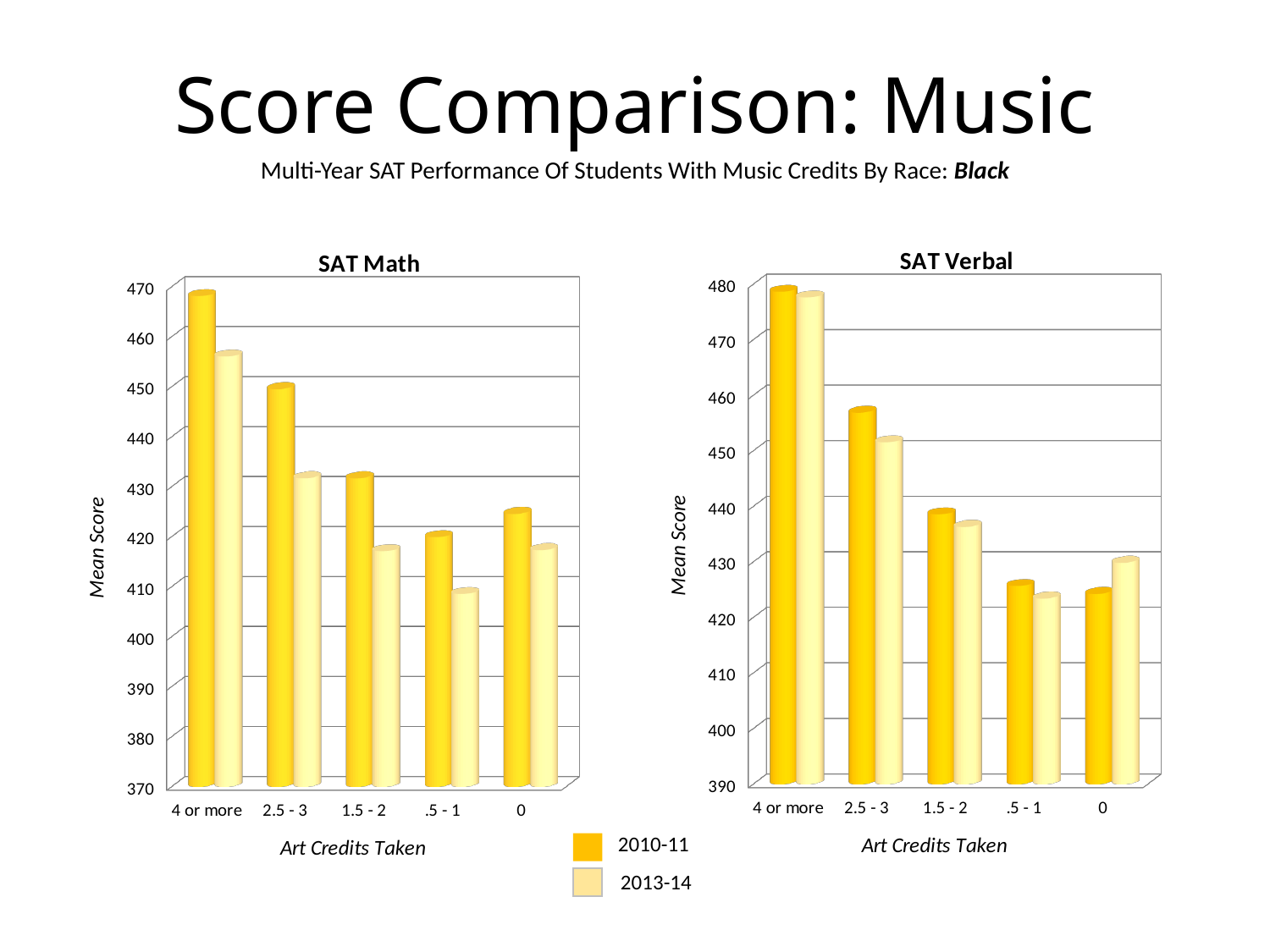
In the SAT Verbal chart, which Art Credits Taken category has the lowest 2013-14 mean score? .5 - 1 In the SAT Math chart, is the 2010-11 value for 4 or more credits greater or less than 460? greater In the SAT Verbal chart, for the 0 credits category, which series has the larger value, 2010-11 or 2013-14? 2013-14 In the SAT Math chart, which Art Credits Taken category has the lowest 2013-14 mean score? .5 - 1 In the SAT Verbal chart, is the 2013-14 value for 0 credits greater or less than 440? less How many series does the legend list for the charts? 2 What is the label on the y axis of the SAT Math chart? Mean Score In the SAT Math chart, for the 4 or more credits category, which series has the larger value, 2010-11 or 2013-14? 2010-11 How many categories are shown on the x axis of the SAT Verbal chart? 5 In the SAT Math chart, which Art Credits Taken category has the highest 2010-11 mean score? 4 or more What kind of chart is the SAT Math chart? bar chart In the SAT Verbal chart, is the 2010-11 value for 2.5 - 3 credits greater or less than 450? greater